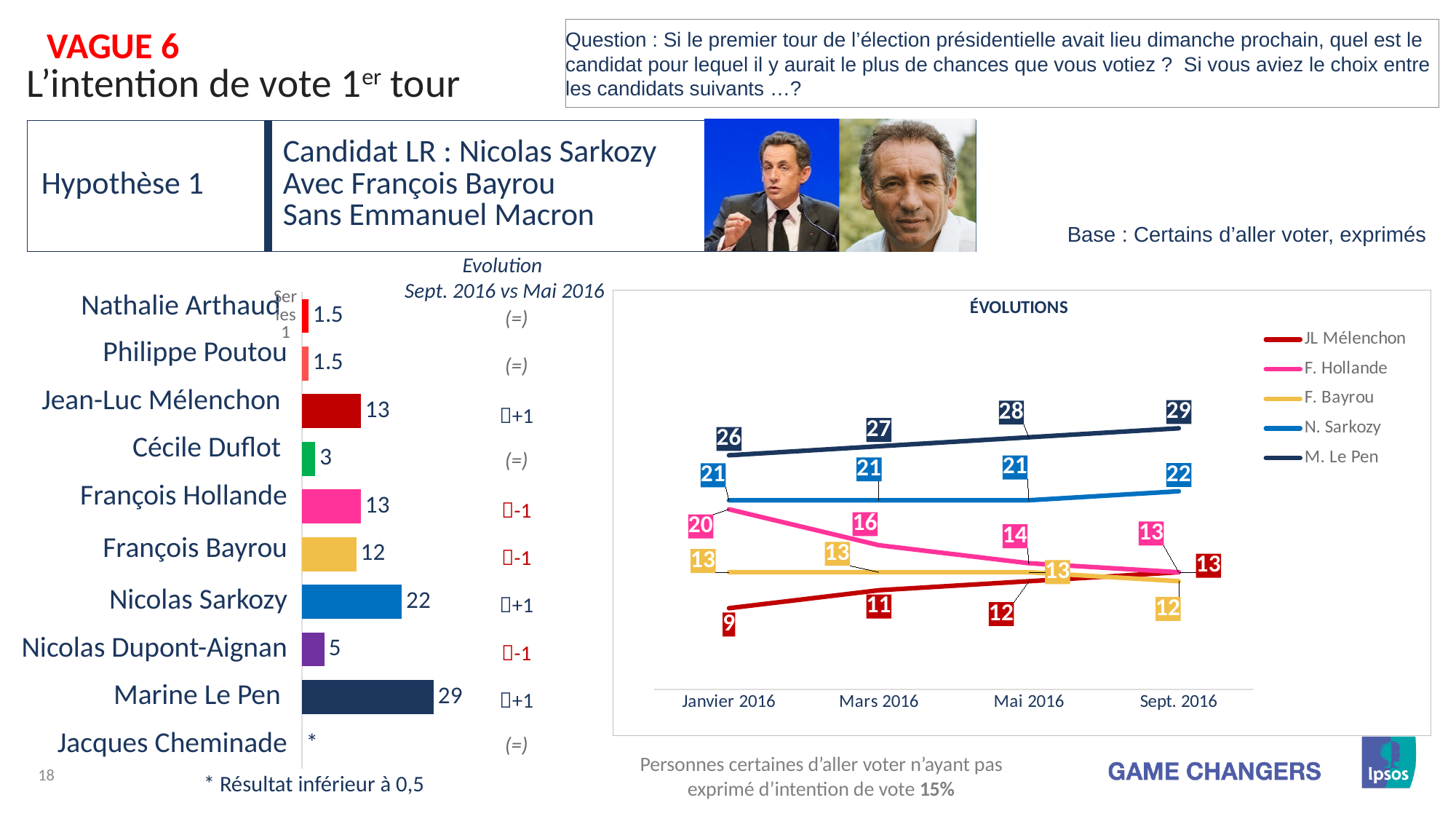
What type of chart is the chart on the left? Bar chart In the ÉVOLUTIONS chart, what is the value for F. Hollande in Janvier 2016? 20 In the ÉVOLUTIONS chart, how many series does the legend list? 5 In the ÉVOLUTIONS chart, does the value for JL Mélenchon rise or fall from Janvier 2016 to Sept. 2016? Rise In the bar chart on the left, what is the value for Cécile Duflot? 3 In the ÉVOLUTIONS chart, how many time points are shown on the x axis? 4 In the bar chart on the left, what is the difference between the values for Marine Le Pen and Nicolas Sarkozy? 7 In the bar chart on the left, which is larger: the value for François Bayrou or the value for Nicolas Dupont-Aignan? François Bayrou In the ÉVOLUTIONS chart, what is the difference between the M. Le Pen value and the N. Sarkozy value in Sept. 2016? 7 In the bar chart on the left, which candidate has the highest value? Marine Le Pen In the bar chart on the left, what is the value for Marine Le Pen? 29 In the bar chart on the left, what is the value for Nicolas Sarkozy? 22